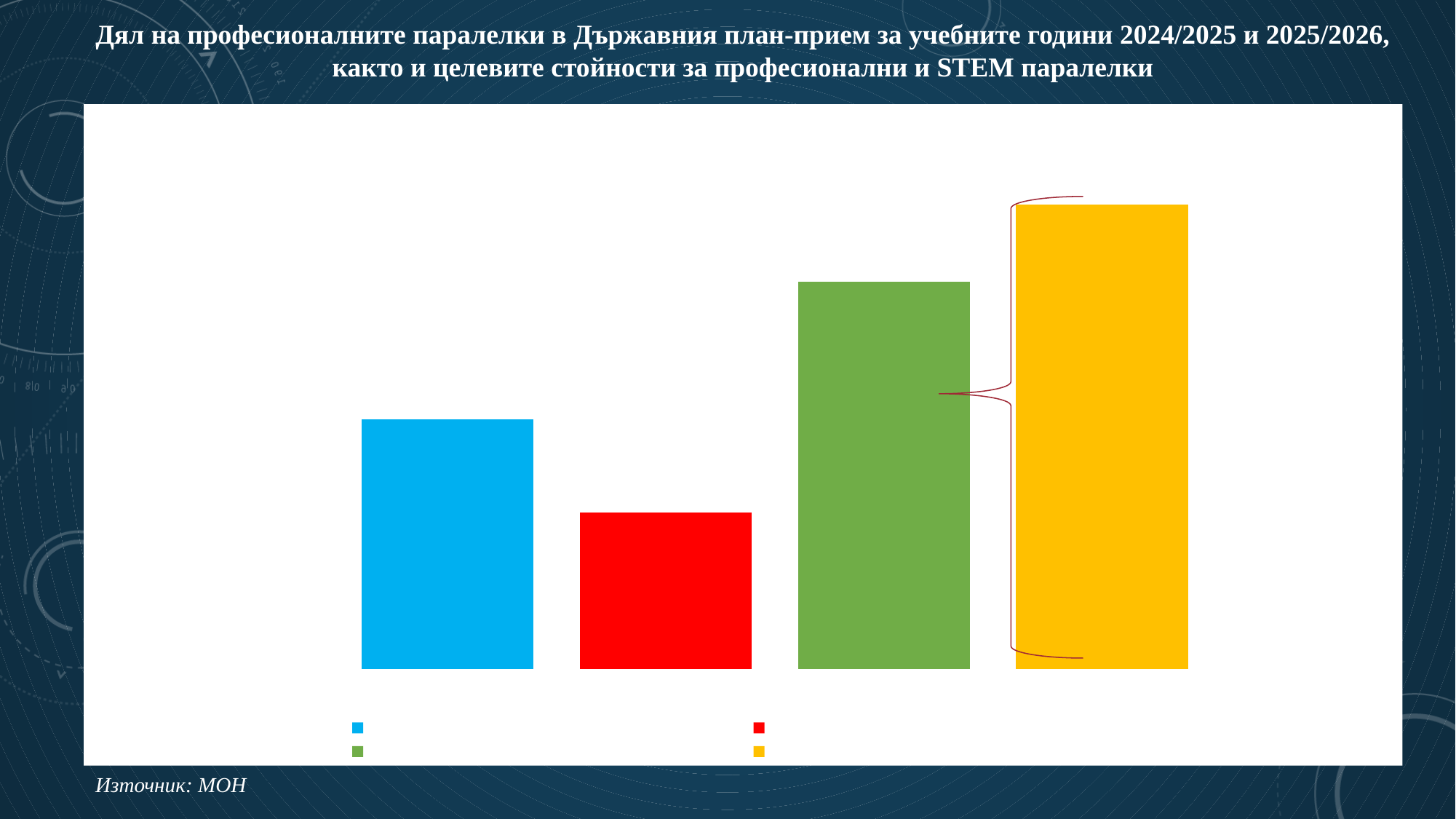
Which is taller, the blue bar or the red bar? the blue bar Which bar is the shortest in the chart? the red bar What kind of chart is shown on the slide? bar chart How many entries does the chart's legend list? 4 What is the colour of the second bar from the left? red What source is cited below the chart? МОН Which is taller, the green bar or the yellow bar? the yellow bar How many bars are plotted in the chart? 4 Which bar is the tallest in the chart? the yellow bar Which is taller, the blue bar or the green bar? the green bar